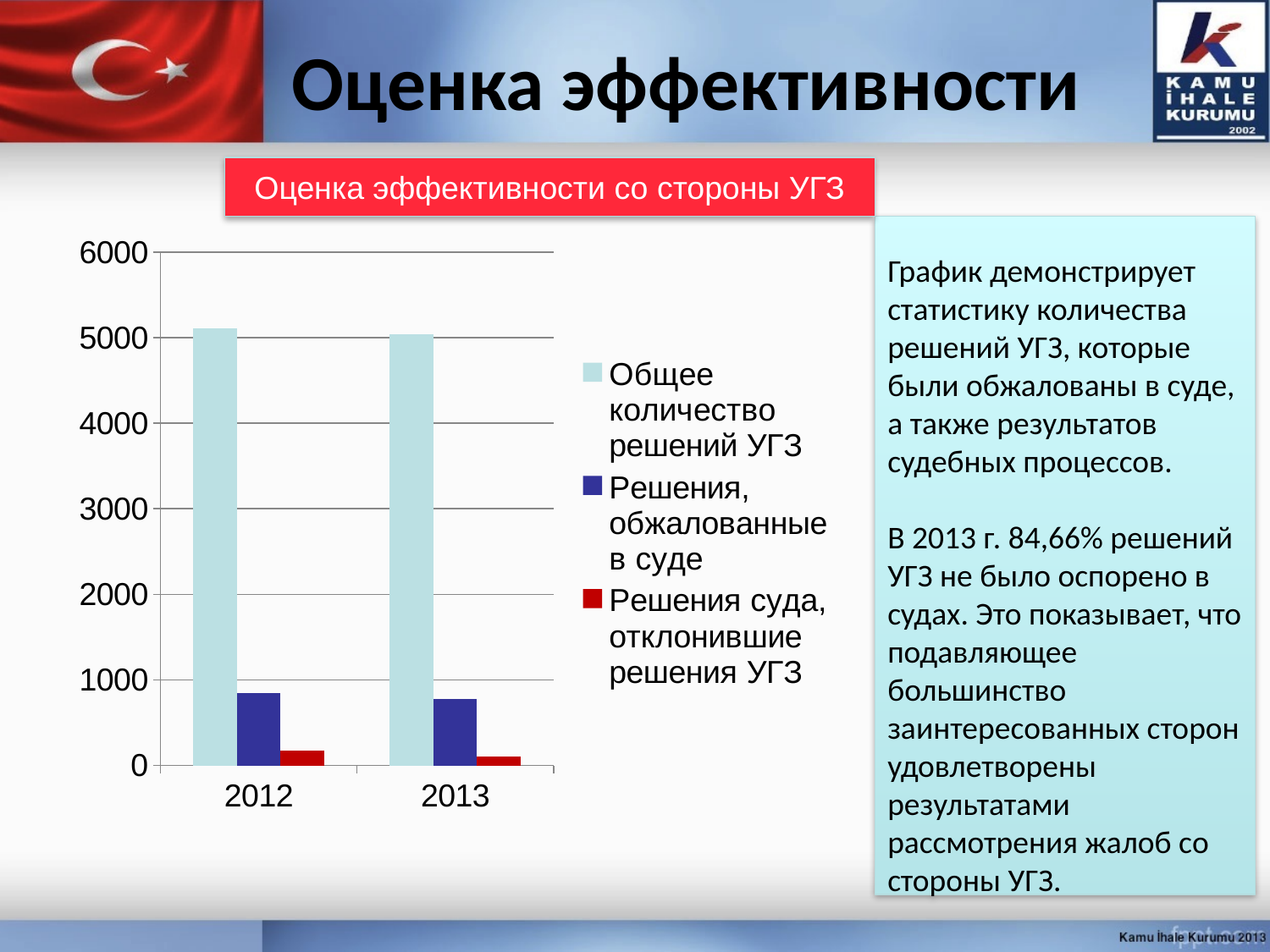
How many series does the chart legend list? 3 Is the value for "Общее количество решений УГЗ" in 2013 greater or less than 6000? less Which series has the lowest value in 2012? Решения суда, отклонившие решения УГЗ Which is larger: "Решения суда, отклонившие решения УГЗ" in 2012 or in 2013? 2012 Is the value for "Общее количество решений УГЗ" in 2012 greater or less than 5000? greater Which is larger in 2013: "Решения, обжалованные в суде" or "Решения суда, отклонившие решения УГЗ"? Решения, обжалованные в суде What is the title shown in the red box above the chart? Оценка эффективности со стороны УГЗ How many years (categories) are shown on the x axis of the chart? 2 Is the value for "Решения суда, отклонившие решения УГЗ" in 2013 greater or less than 1000? less What kind of chart is shown on the slide? bar chart Which series has the highest value in 2013? Общее количество решений УГЗ